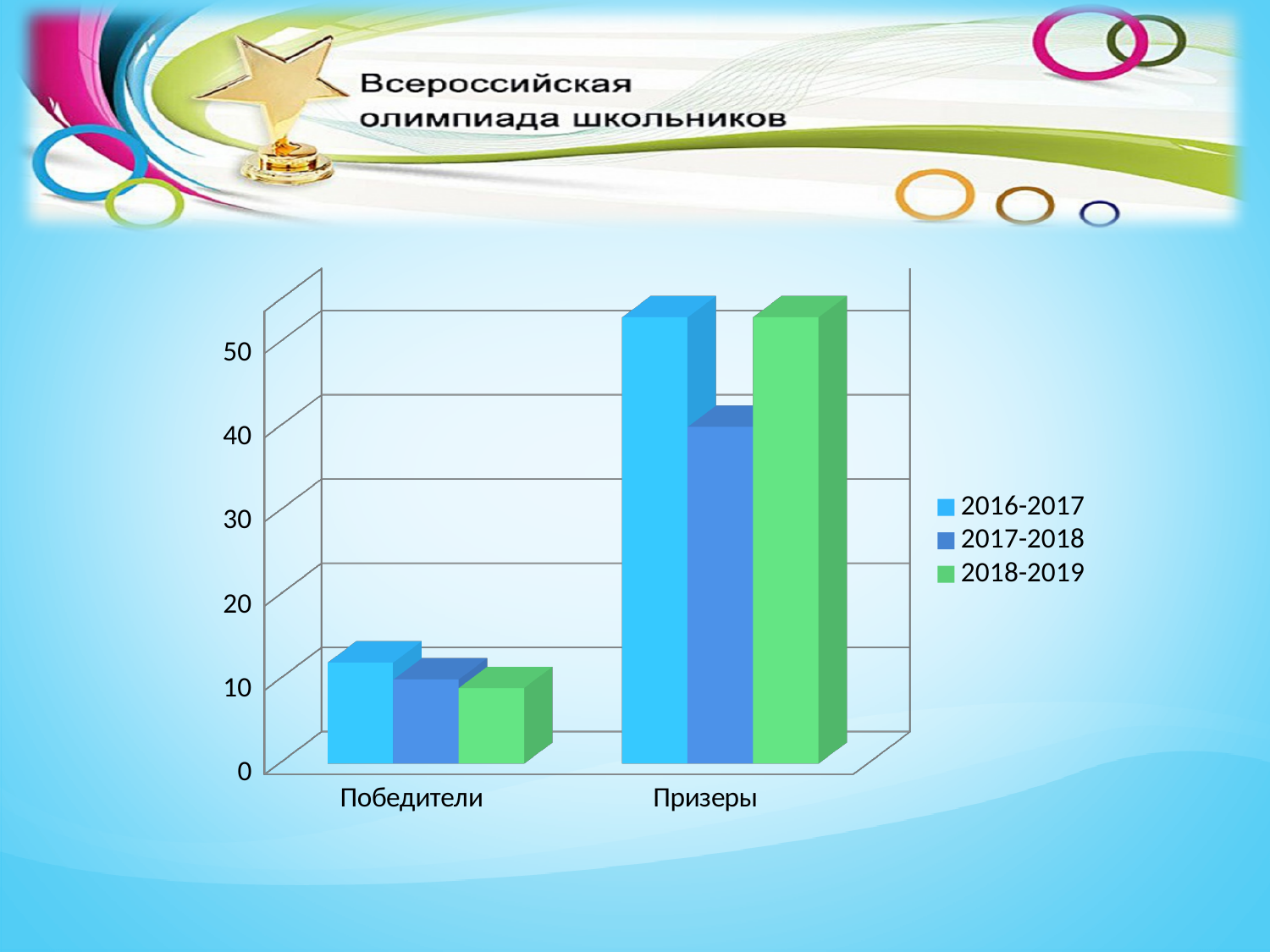
For the Призеры category, which series has the lowest value? 2017-2018 Is the value for Победители in 2016-2017 greater or less than 20? less How many series does the chart legend list? 3 For the 2017-2018 series, which category has the larger value: Победители or Призеры? Призеры What are the two categories on the x axis of the chart? Победители, Призеры Is the value for Победители in 2018-2019 greater or less than 20? less For the Призеры category, which is larger: the value for 2016-2017 or for 2017-2018? 2016-2017 Is the value for Призеры in 2016-2017 greater or less than 50? greater How many categories are shown on the x axis of the chart? 2 What kind of chart is shown on the slide? bar chart Which series are listed in the chart legend? 2016-2017, 2017-2018, 2018-2019